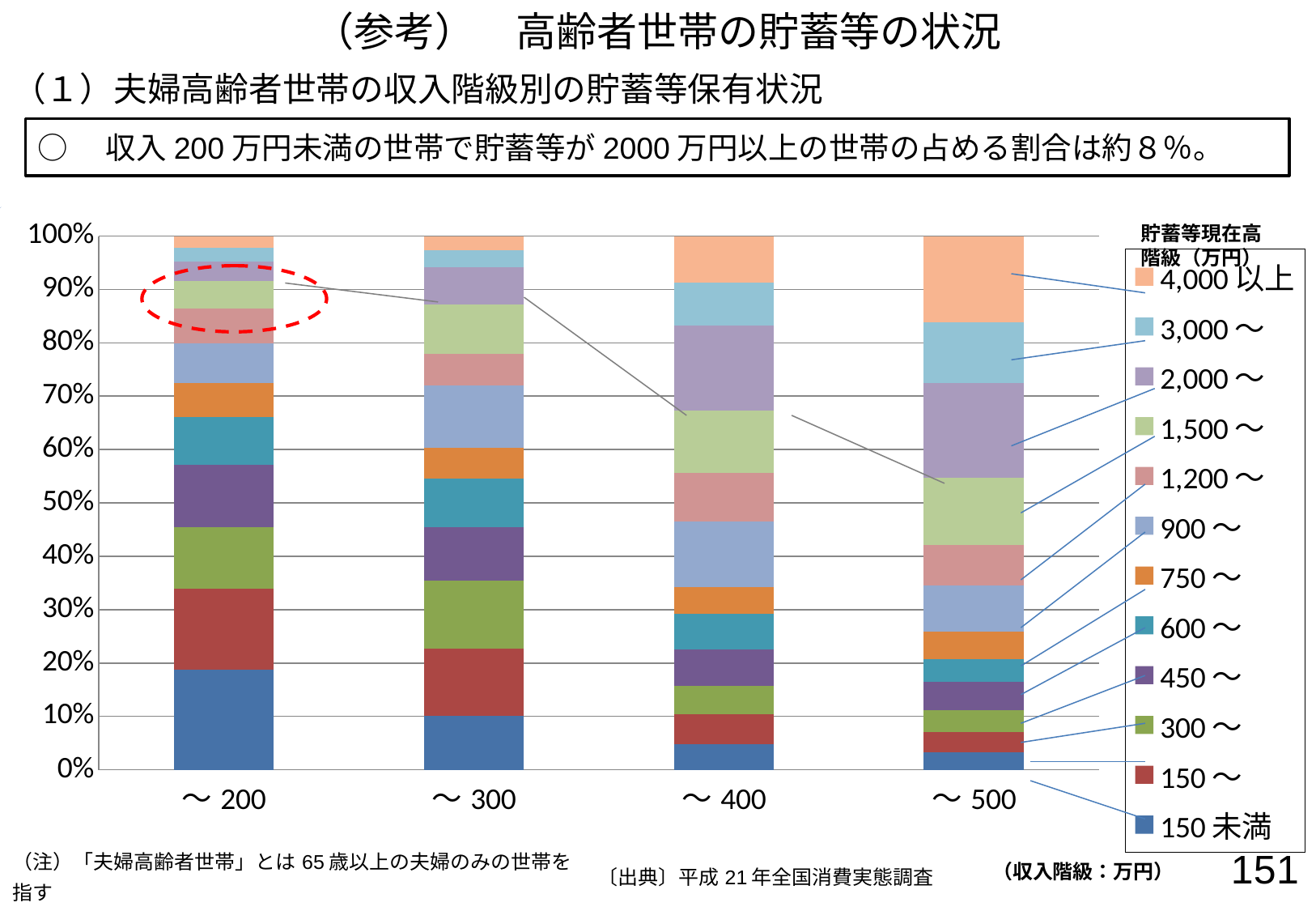
Is the share of the 4,000以上 segment in the ～200 bar greater or less than 10%? less How many income-class categories are plotted along the x axis? 4 What kind of chart is shown on the slide? stacked bar chart Is the share of the 150未満 segment in the ～200 bar greater or less than 10%? greater Which income class has the smallest 150未満 segment? ～500 Does the share of the 150未満 segment rise or fall as income class increases from ～200 to ～500? fall Which income class has the largest 4,000以上 segment? ～500 Is the share of the 150未満 segment in the ～500 bar greater or less than 10%? less What is the title shown above the legend? 貯蓄等現在高階級（万円） How many series does the legend list? 12 Which income class has the larger 150未満 segment, ～200 or ～500? ～200